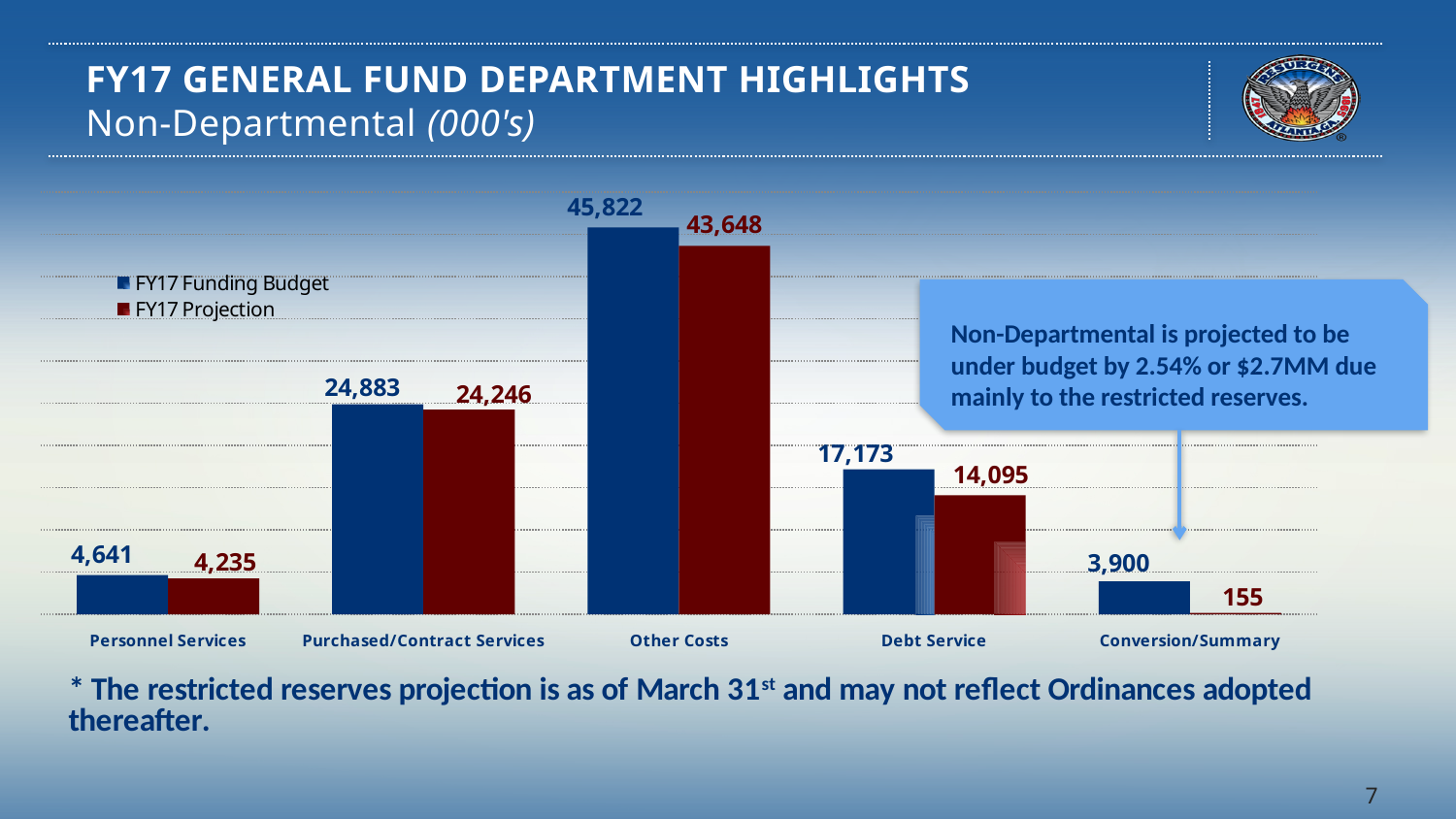
What kind of chart is shown on the slide? Bar chart How many categories are shown on the x axis of the chart? 5 How many series does the legend list? 2 Which is larger for Purchased/Contract Services: the FY17 Funding Budget or the FY17 Projection? FY17 Funding Budget What is the FY17 Funding Budget value for Purchased/Contract Services? 24,883 What is the FY17 Funding Budget value for Other Costs? 45,822 What is the difference between the FY17 Funding Budget and FY17 Projection for Personnel Services? 406 What is the FY17 Projection value for Debt Service? 14,095 Which category has the lowest FY17 Projection value? Conversion/Summary Which category has the highest FY17 Funding Budget value? Other Costs What is the FY17 Projection value for Conversion/Summary? 155 What is the difference between the FY17 Funding Budget and FY17 Projection for Debt Service? 3,078